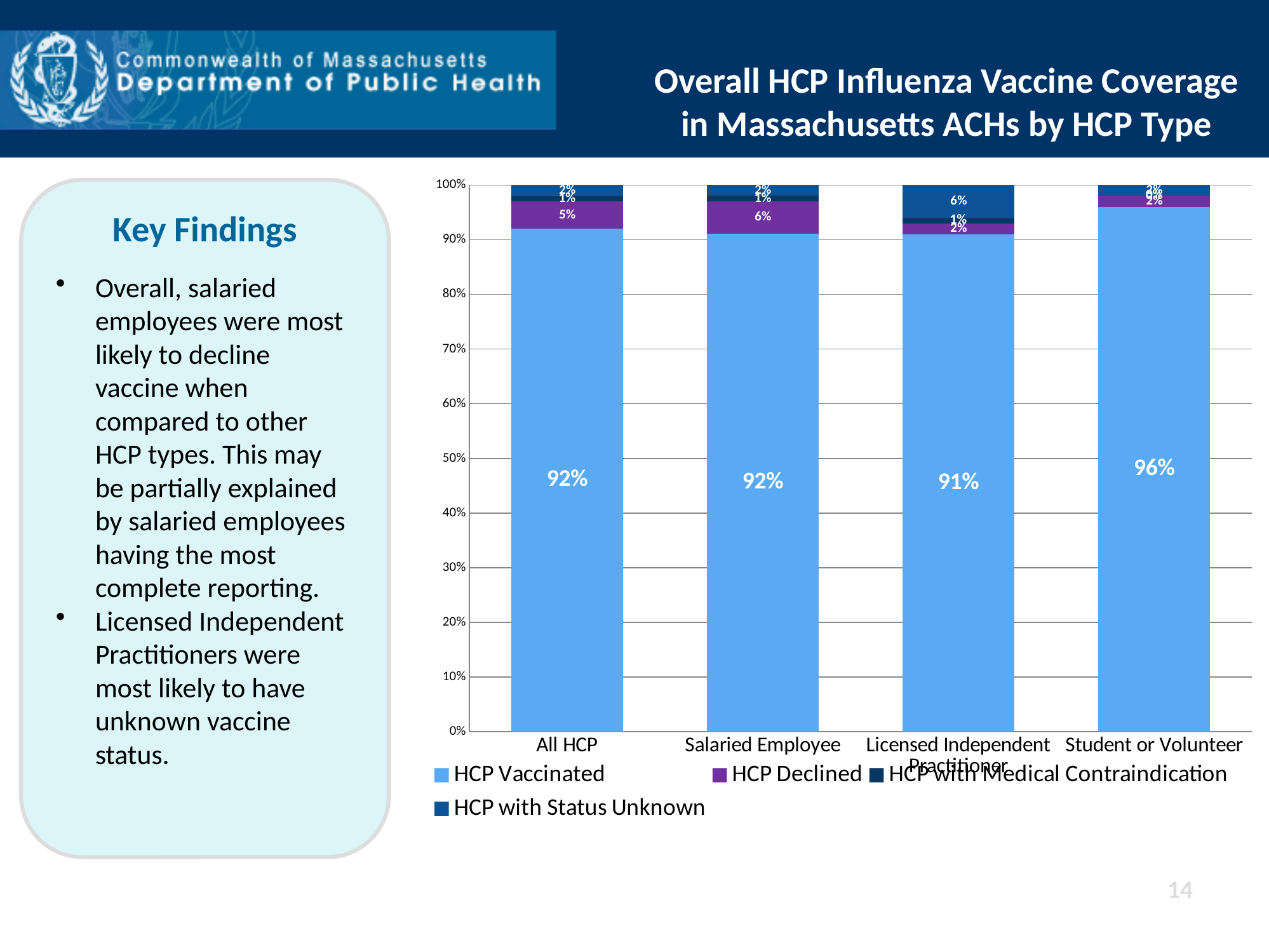
Which series is shown in purple in the chart? HCP Declined What is the HCP Vaccinated value for Student or Volunteer? 96% What is the difference between the HCP Vaccinated values for Student or Volunteer and Licensed Independent Practitioner? 5% Which HCP type has the highest HCP Vaccinated percentage? Student or Volunteer What is the HCP Declined value for All HCP? 5% How many series does the chart legend list? 4 What type of chart is shown on the slide? stacked bar chart What is the HCP with Status Unknown value for Licensed Independent Practitioner? 6% Which HCP type has the highest HCP Declined percentage? Salaried Employee How many HCP type categories are shown on the x axis of the chart? 4 What is the HCP Declined value for Salaried Employee? 6% What is the HCP Vaccinated value for Licensed Independent Practitioner? 91%